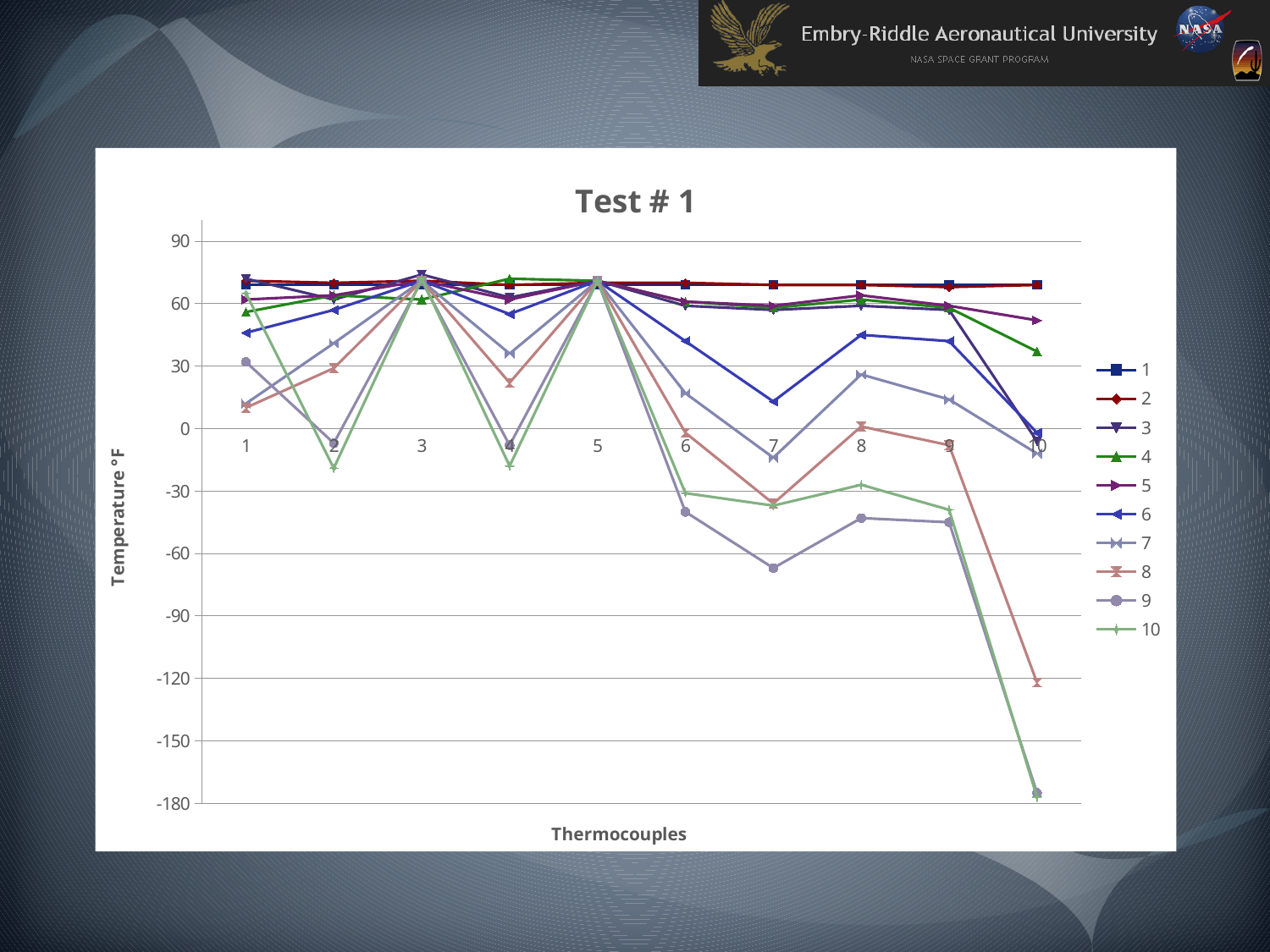
Is the value of series 7 at thermocouple 2 greater or less than 30? greater Which series has the lowest value at thermocouple 7? 9 How many thermocouples are plotted along the x axis? 10 What is the title of the chart? Test # 1 Is the value of series 10 at thermocouple 6 greater or less than 0? less How many series does the legend list? 10 What kind of chart is shown on the slide? line chart Is the value of series 1 at thermocouple 1 greater or less than 60? greater What is the label of the vertical axis? Temperature °F At thermocouple 7, which is larger: the value of series 6 or series 7? series 6